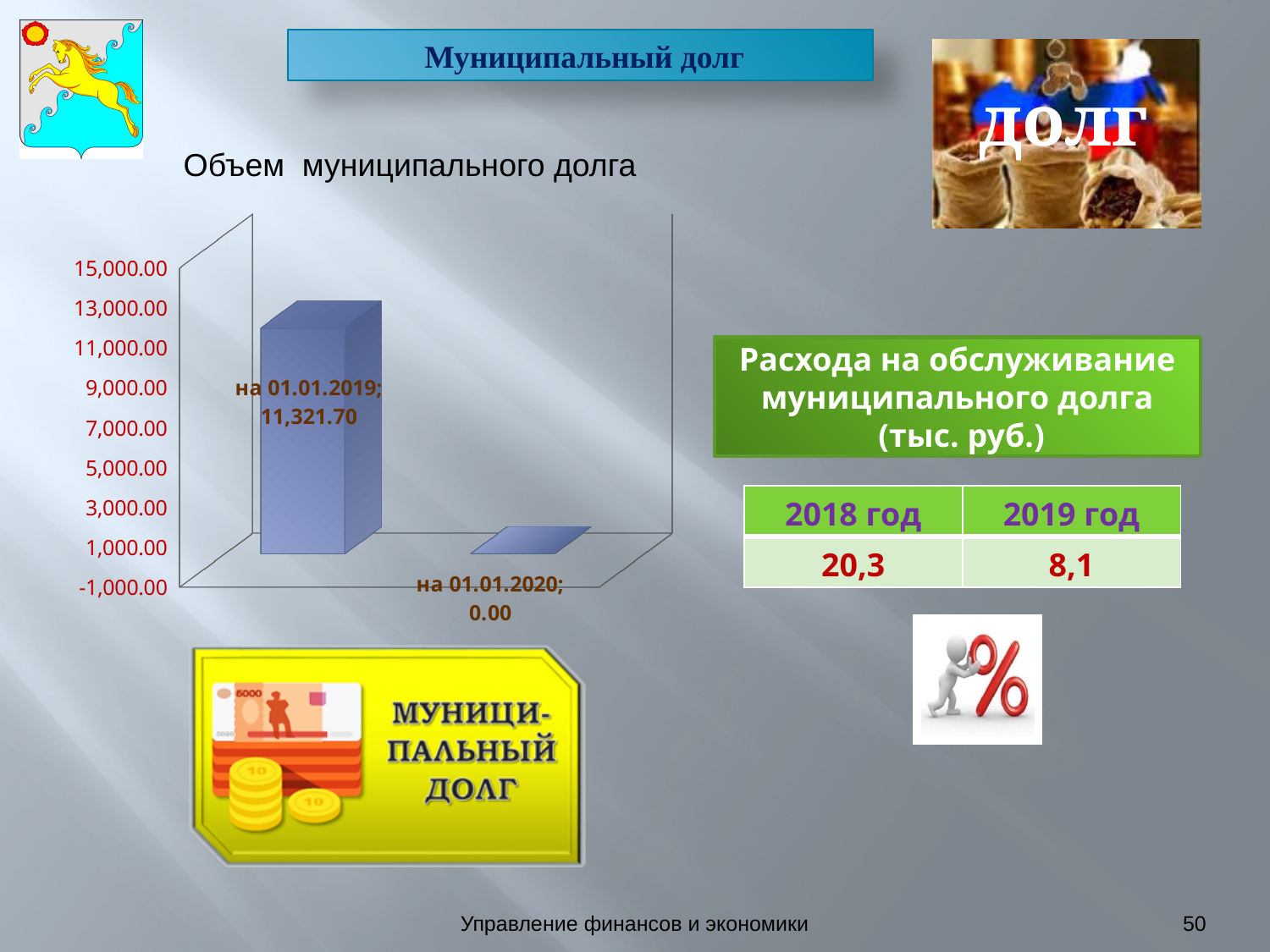
What is the value of municipal debt shown for на 01.01.2019? 11,321.70 Which date has the lower municipal debt value on the chart? на 01.01.2020 Is the municipal debt value for на 01.01.2019 greater or less than 9,000.00? greater Does the municipal debt rise or fall from 01.01.2019 to 01.01.2020? fall What is the value of municipal debt shown for на 01.01.2020? 0.00 What is the difference between the municipal debt on 01.01.2019 and on 01.01.2020? 11,321.70 What is the highest value shown on the chart's vertical axis? 15,000.00 Is the municipal debt value for на 01.01.2019 greater or less than 13,000.00? less Which date has the higher municipal debt value on the chart? на 01.01.2019 What is the title of the chart on the slide? Объем муниципального долга How many categories (dates) are plotted on the chart? 2 What type of chart is used to show the volume of municipal debt? bar chart